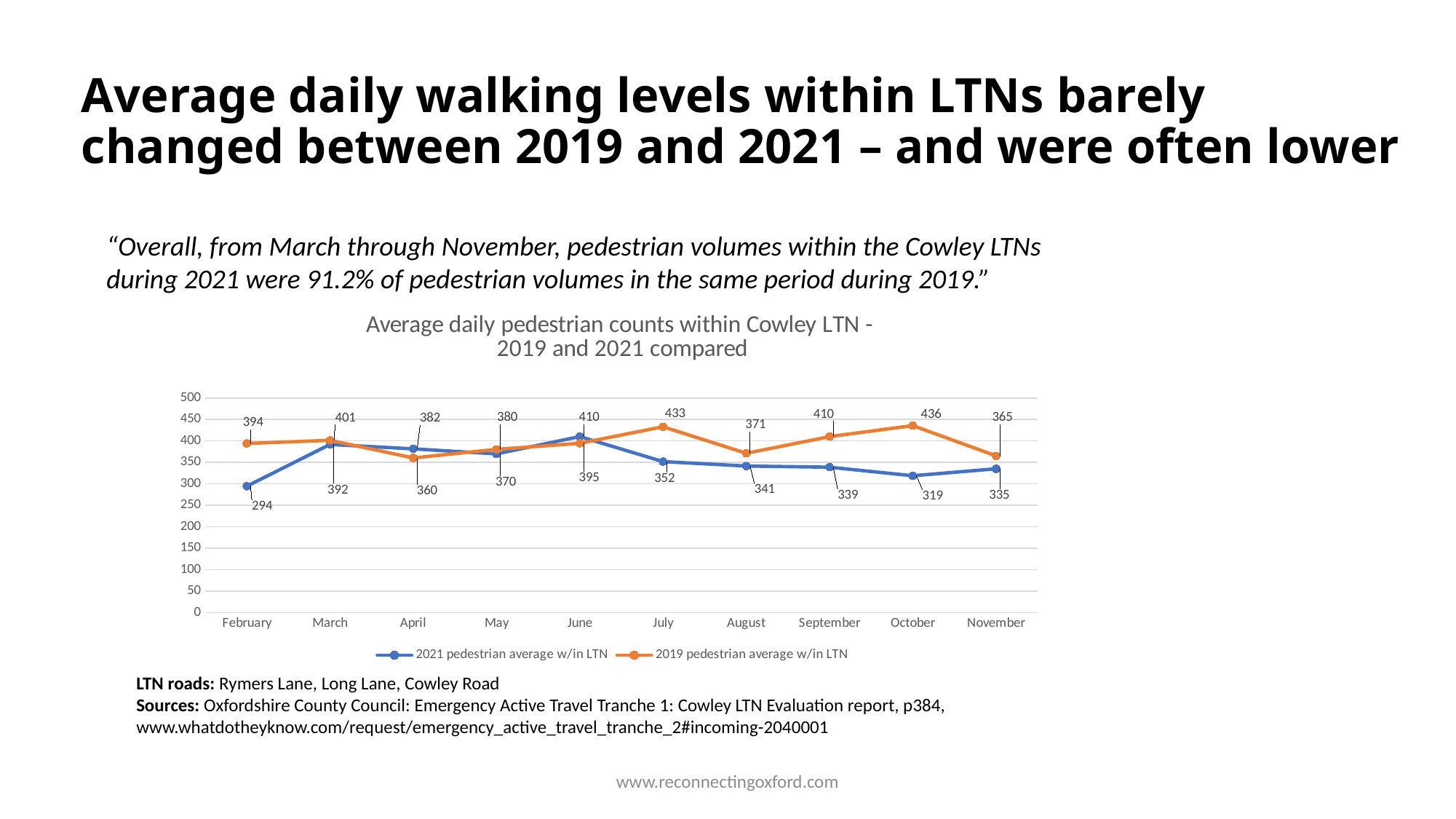
What is the difference between the 2019 and 2021 pedestrian averages in October? 117 Does the 2021 pedestrian average within the LTN rise or fall from June to October? Fall How many months are plotted along the x axis? 10 What is the 2021 pedestrian average within the LTN for February? 294 In April, which series has the higher value: 2021 or 2019 pedestrian average within the LTN? 2021 pedestrian average w/in LTN In which month is the 2021 pedestrian average within the LTN lowest? February What is the title of the chart? Average daily pedestrian counts within Cowley LTN - 2019 and 2021 compared What is the 2021 pedestrian average within the LTN for June? 410 In which month is the 2019 pedestrian average within the LTN highest? October How many series does the chart legend list? 2 What type of chart is shown on the slide? Line chart What is the 2019 pedestrian average within the LTN for October? 436